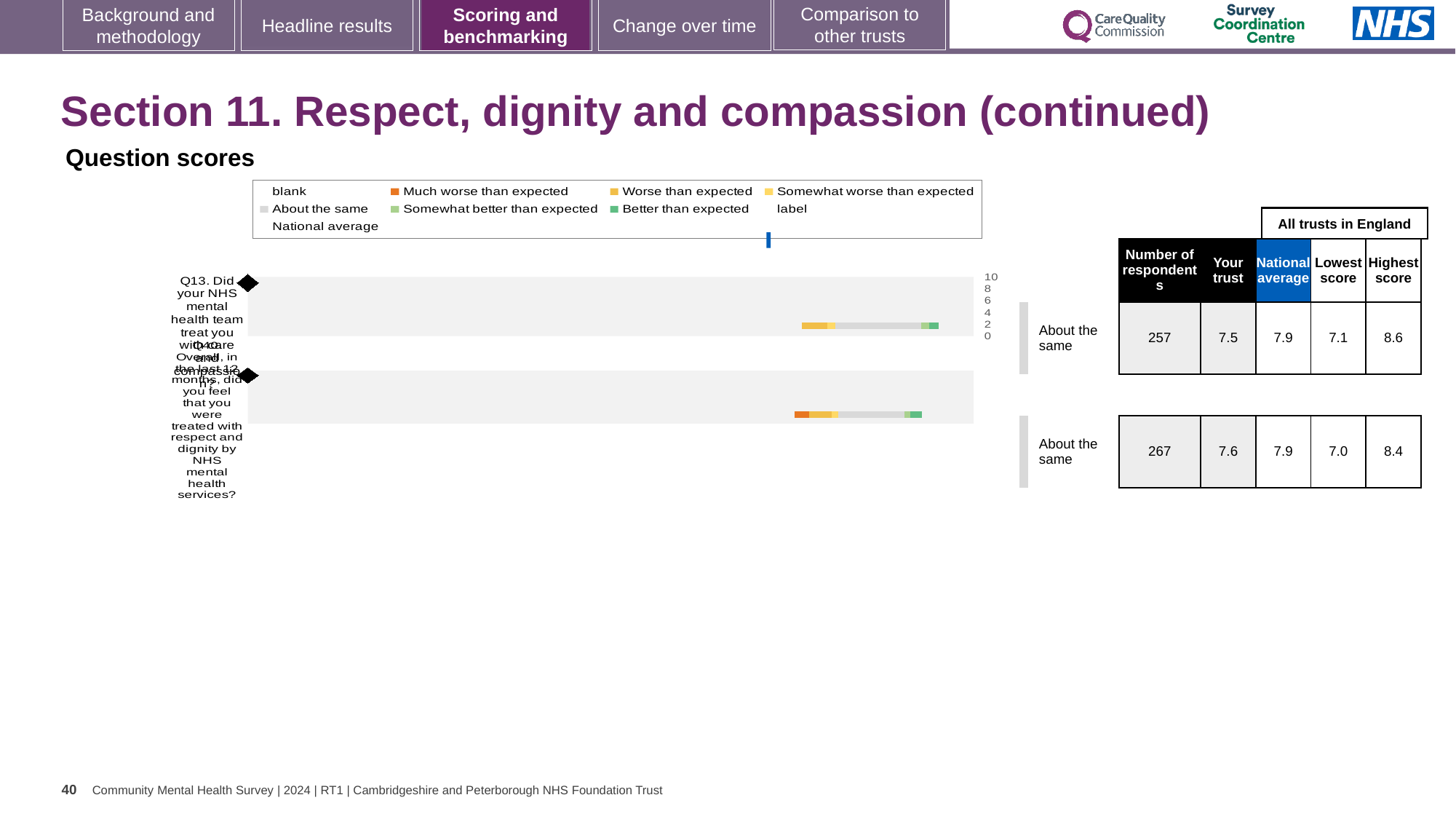
What is the highest score among all trusts in England for Q13? 8.6 What benchmark category is shown for both Q13 and Q40? About the same What is the lowest score among all trusts in England for Q40? 7.0 How much lower is the trust's score than the national average for Q40? 0.3 What is the 'Your trust' score for Q13 (treated with care and compassion)? 7.5 Which question has the higher 'Your trust' score, Q13 or Q40? Q40 What is the national average score for Q40 (treated with respect and dignity)? 7.9 What is the difference between the highest and lowest trust scores for Q13? 1.5 How many questions (categories) are plotted in the question scores chart? 2 What type of chart is used to show the question scores on this slide? bar chart How many respondents answered Q13? 257 How many respondents answered Q40? 267